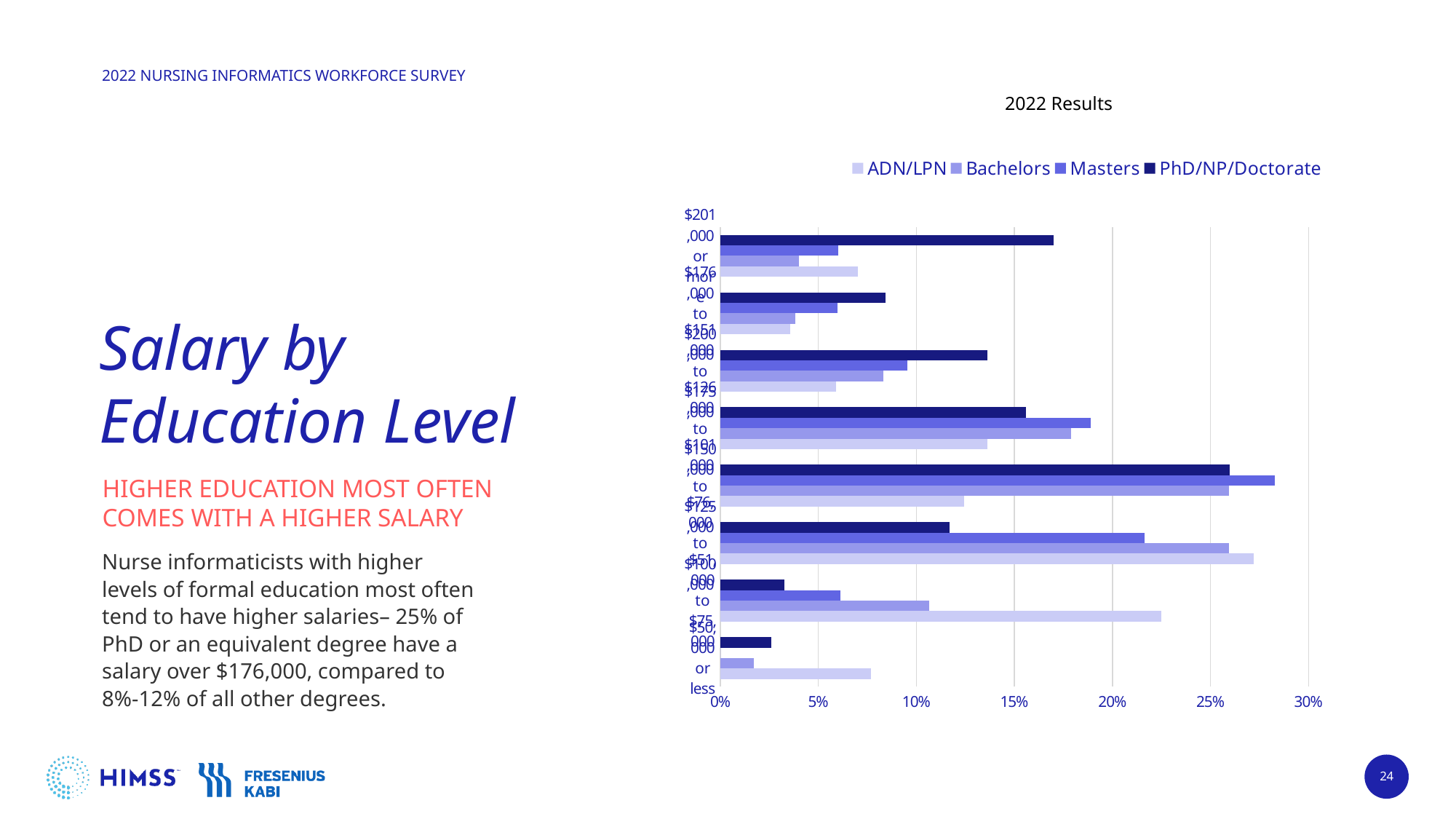
Is the PhD/NP/Doctorate value for the "$201,000 or more" category greater or less than 15%? greater In the "$201,000 or more" category, which series has the shortest bar? Bachelors Is the ADN/LPN value for the "$50,000 or less" category greater or less than 10%? less How many salary range categories are plotted on the chart? 8 Is the ADN/LPN value for the "$201,000 or more" category greater or less than 10%? less What is the title of the chart? 2022 Results How many series does the chart legend list? 4 What are the series listed in the chart legend? ADN/LPN, Bachelors, Masters, PhD/NP/Doctorate In the "$201,000 or more" category, which series has the longest bar? PhD/NP/Doctorate In the "$50,000 or less" category, which is larger: the ADN/LPN value or the PhD/NP/Doctorate value? ADN/LPN What kind of chart is shown on the slide? Bar chart